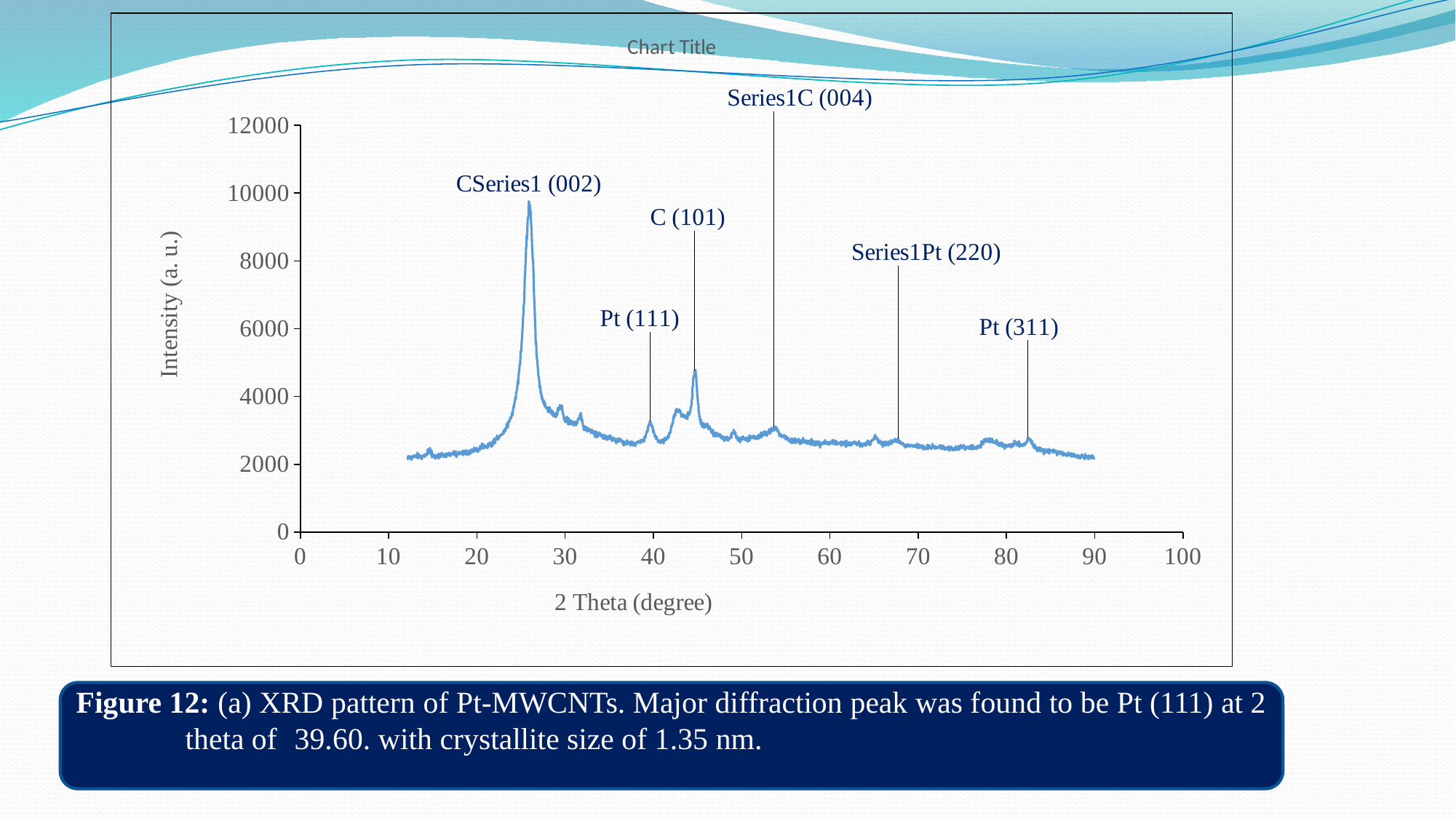
How many labeled peaks are marked on the chart? 6 Is the intensity of the C (101) peak greater or less than 6000? less Is the intensity of the CSeries1 (002) peak greater or less than 10000? less What is the title of the chart's x axis? 2 Theta (degree) Is the intensity of the Series1Pt (220) peak greater or less than 4000? less What kind of chart is shown on the slide? line chart What is the title of the chart's y axis? Intensity (a. u.) Which peak has a higher intensity, C (101) or Pt (311)? C (101) Which labeled peak has the highest intensity? CSeries1 (002)